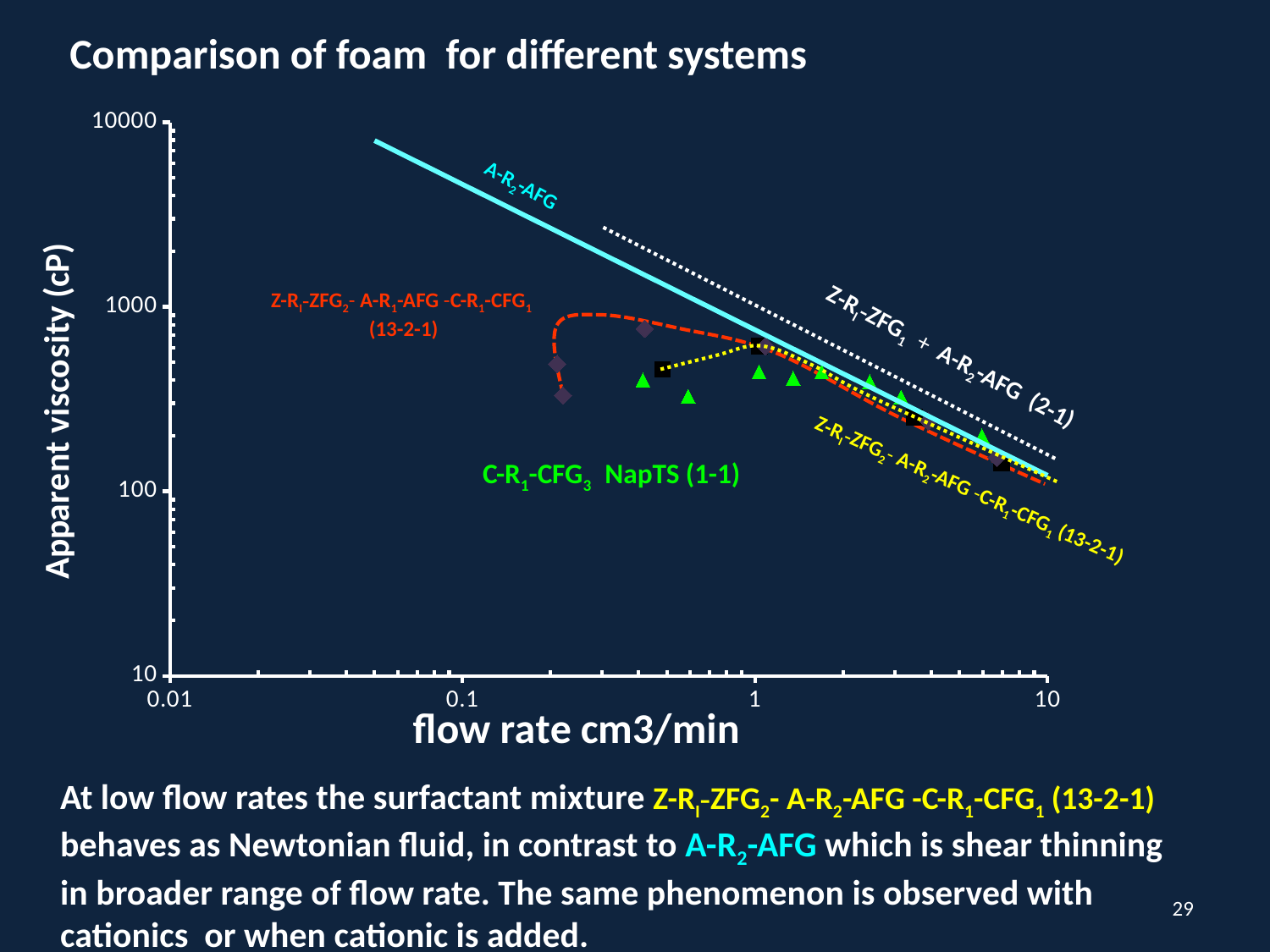
What is the label of the vertical axis? Apparent viscosity (cP) At a flow rate of about 0.6 cm3/min, which has the higher apparent viscosity, A-R2-AFG or C-R1-CFG3 NapTS (1-1)? A-R2-AFG What is the title of the chart? Comparison of foam for different systems Does the apparent viscosity of A-R2-AFG rise or fall as the flow rate increases? Fall Are the apparent viscosity values of C-R1-CFG3 NapTS (1-1) greater or less than 100 cP? greater Which series reaches the highest apparent viscosity on the chart? A-R2-AFG How many labelled series are plotted on the chart? 5 Is the apparent viscosity of A-R2-AFG at a flow rate of 0.1 cm3/min greater or less than 1000 cP? greater Is the apparent viscosity of C-R1-CFG3 NapTS (1-1) at a flow rate of 1 cm3/min greater or less than 1000 cP? less Which lies higher on the chart, the Z-R1-ZFG1 + A-R2-AFG (2-1) line or the A-R2-AFG line? Z-R1-ZFG1 + A-R2-AFG (2-1) What kind of chart is shown on the slide? Line chart